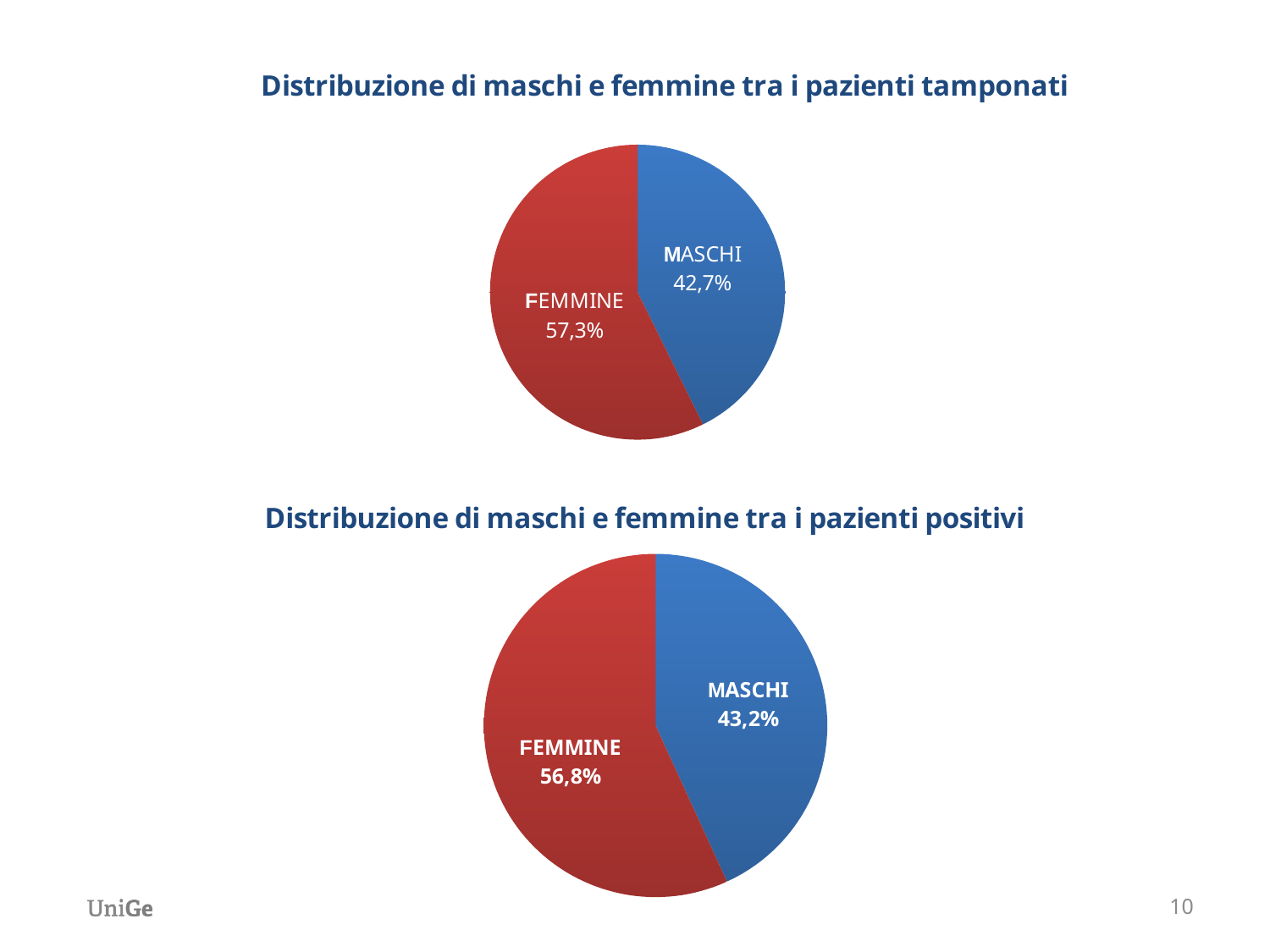
In the top chart, what colour is the MASCHI slice? Blue How many slices does the bottom chart have? 2 In the chart titled 'Distribuzione di maschi e femmine tra i pazienti tamponati', what is the share for MASCHI? 42,7% In the chart titled 'Distribuzione di maschi e femmine tra i pazienti positivi', what is the share for MASCHI? 43,2% What kind of chart is the top chart on the slide? Pie chart In the chart titled 'Distribuzione di maschi e femmine tra i pazienti tamponati', what is the share for FEMMINE? 57,3% In the top chart, what is the difference between the FEMMINE and MASCHI shares? 14,6% In the bottom chart, which category has the smallest slice? MASCHI In the top chart, which category has the largest slice? FEMMINE In the bottom chart, which is larger, the MASCHI slice or the FEMMINE slice? FEMMINE In the bottom chart, what is the difference between the FEMMINE and MASCHI shares? 13,6% In the chart titled 'Distribuzione di maschi e femmine tra i pazienti positivi', what is the share for FEMMINE? 56,8%